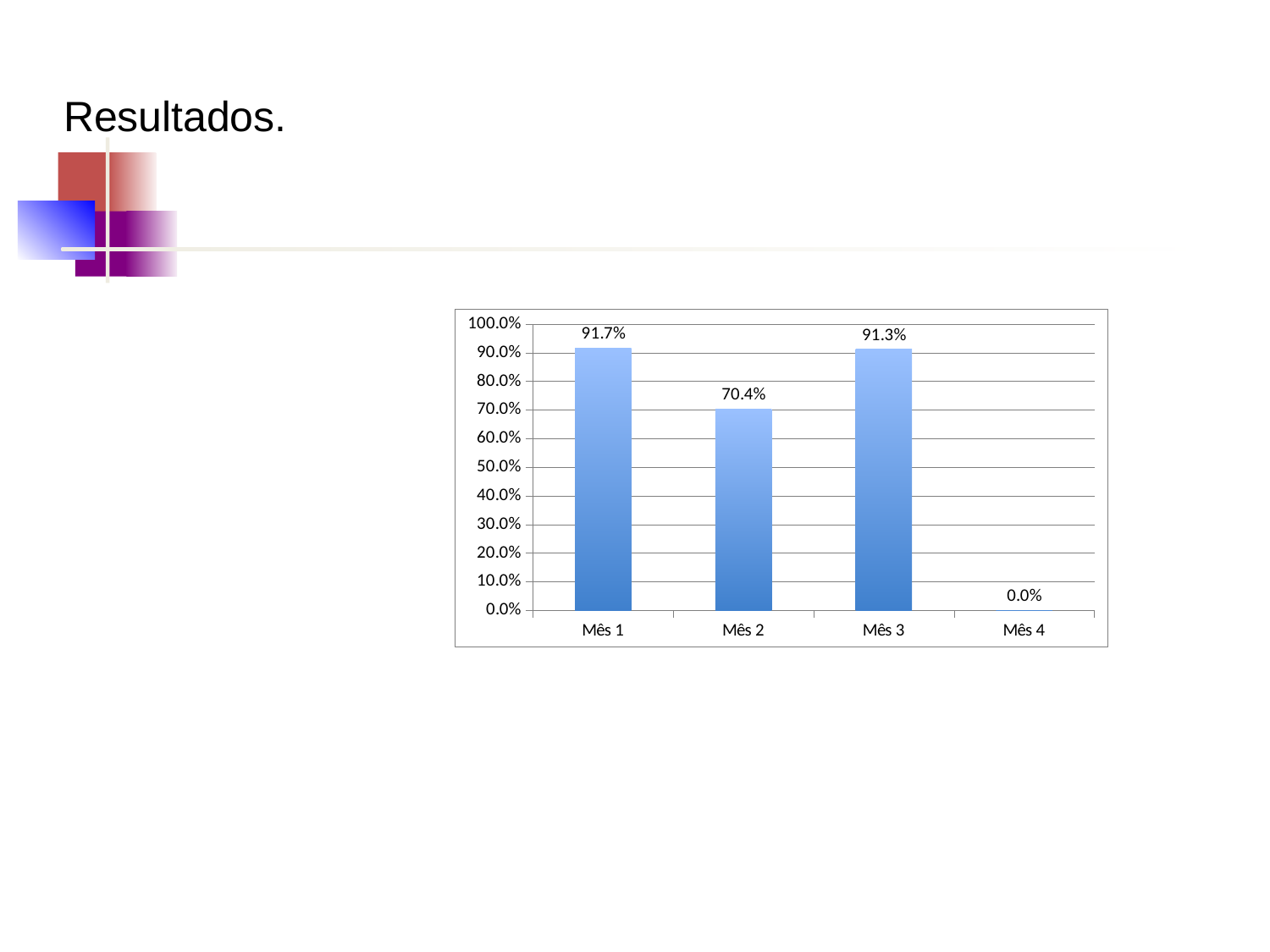
What is the value for Mês 1? 91.7% Which category has the lowest value? Mês 4 Is the value for Mês 2 greater or less than 80.0%? less Which is larger, the value for Mês 2 or the value for Mês 3? Mês 3 What is the title of the slide containing the chart? Resultados. How many categories are shown on the x axis? 4 Which category has the highest value? Mês 1 What is the value for Mês 4? 0.0% What kind of chart is shown on the slide? bar chart What is the value for Mês 2? 70.4% What is the value for Mês 3? 91.3% What is the difference between the values for Mês 1 and Mês 2? 21.3%